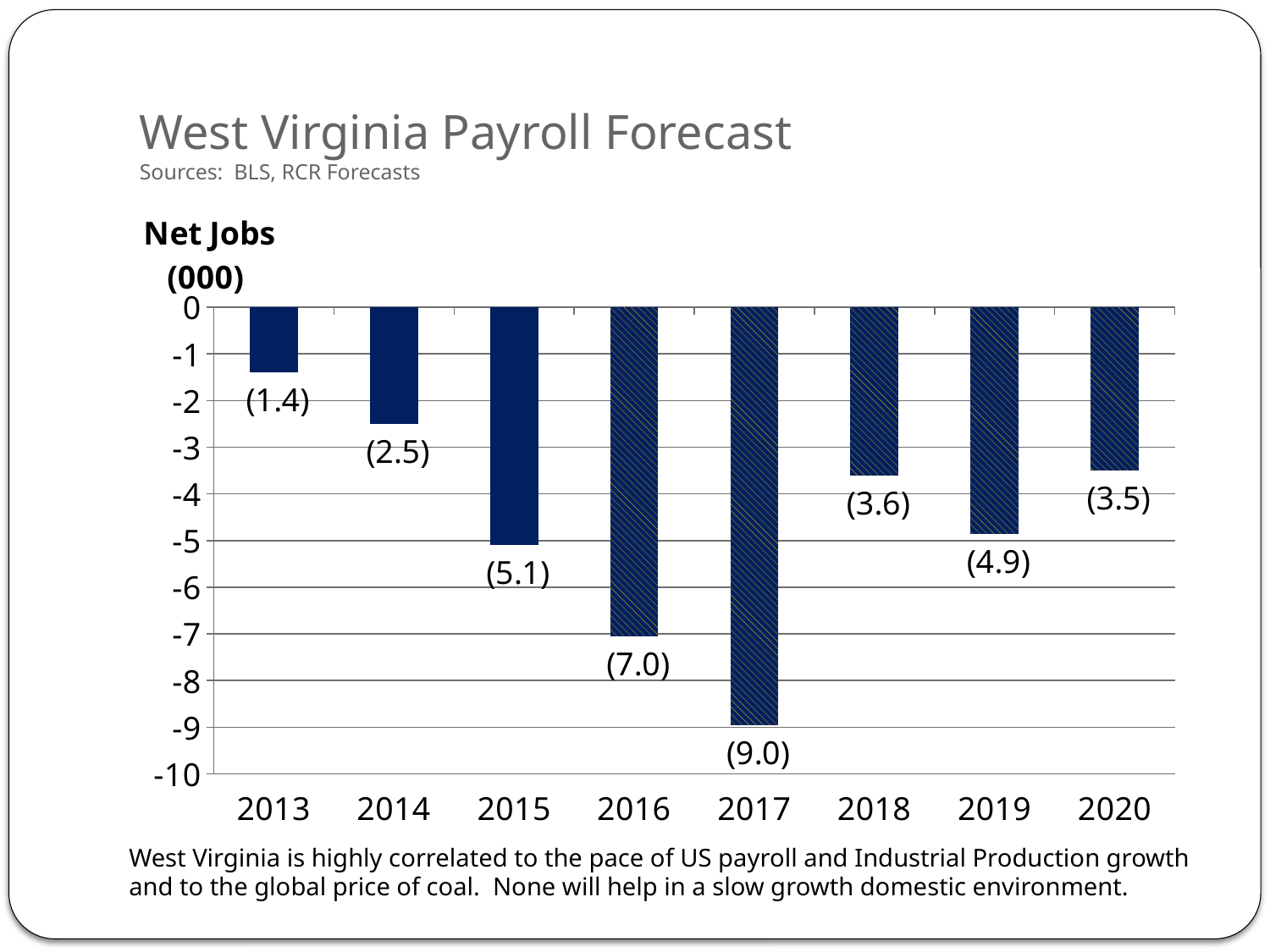
Which year has a larger net job loss, 2015 or 2018? 2015 What is the value shown for 2013? (1.4) What kind of chart is shown on the slide? Bar chart What is the value shown for 2019? (4.9) How many years are plotted on the chart? 8 Which year shows the smallest net job loss? 2013 From 2013 to 2017, do the net job losses grow or shrink each year? Grow What is the title of the chart? West Virginia Payroll Forecast What is the value shown for 2017? (9.0) What is the value shown for 2016? (7.0) Which year shows the largest net job loss? 2017 By how much does the job loss in 2017 exceed the job loss in 2016, in thousands? 2.0